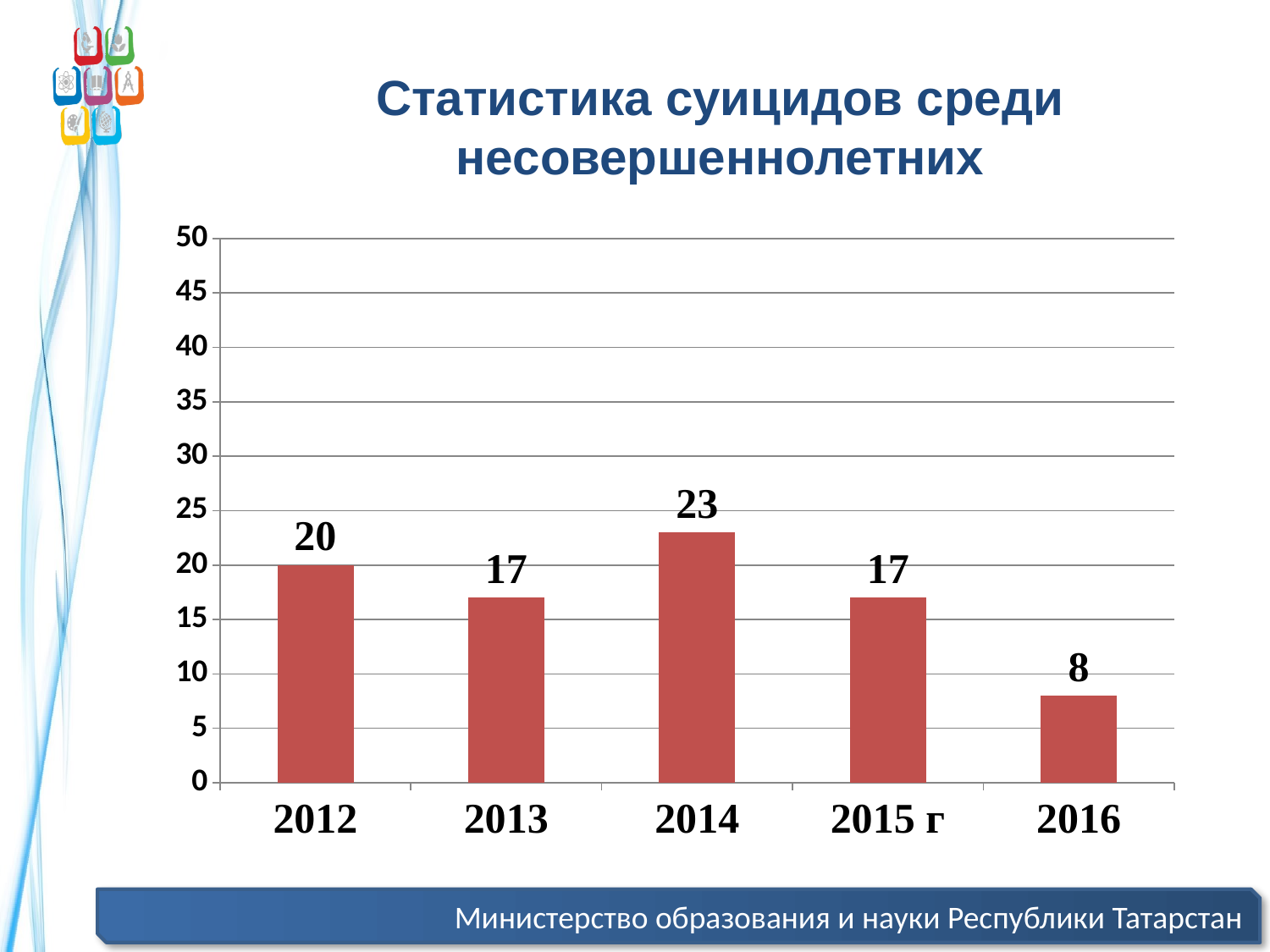
What is the value for 2016? 8 Which year has the lowest value? 2016 What kind of chart is shown on the slide? bar chart What is the difference between the values for 2012 and 2013? 3 Which year has the highest value? 2014 What is the value for 2012? 20 What is the difference between the values for 2014 and 2016? 15 How many years are shown on the x axis? 5 What is the value for 2014? 23 Is the value for 2014 greater or less than 25? less Which is larger, the value for 2012 or the value for 2015 г? 2012 What is the title of the slide? Статистика суицидов среди несовершеннолетних